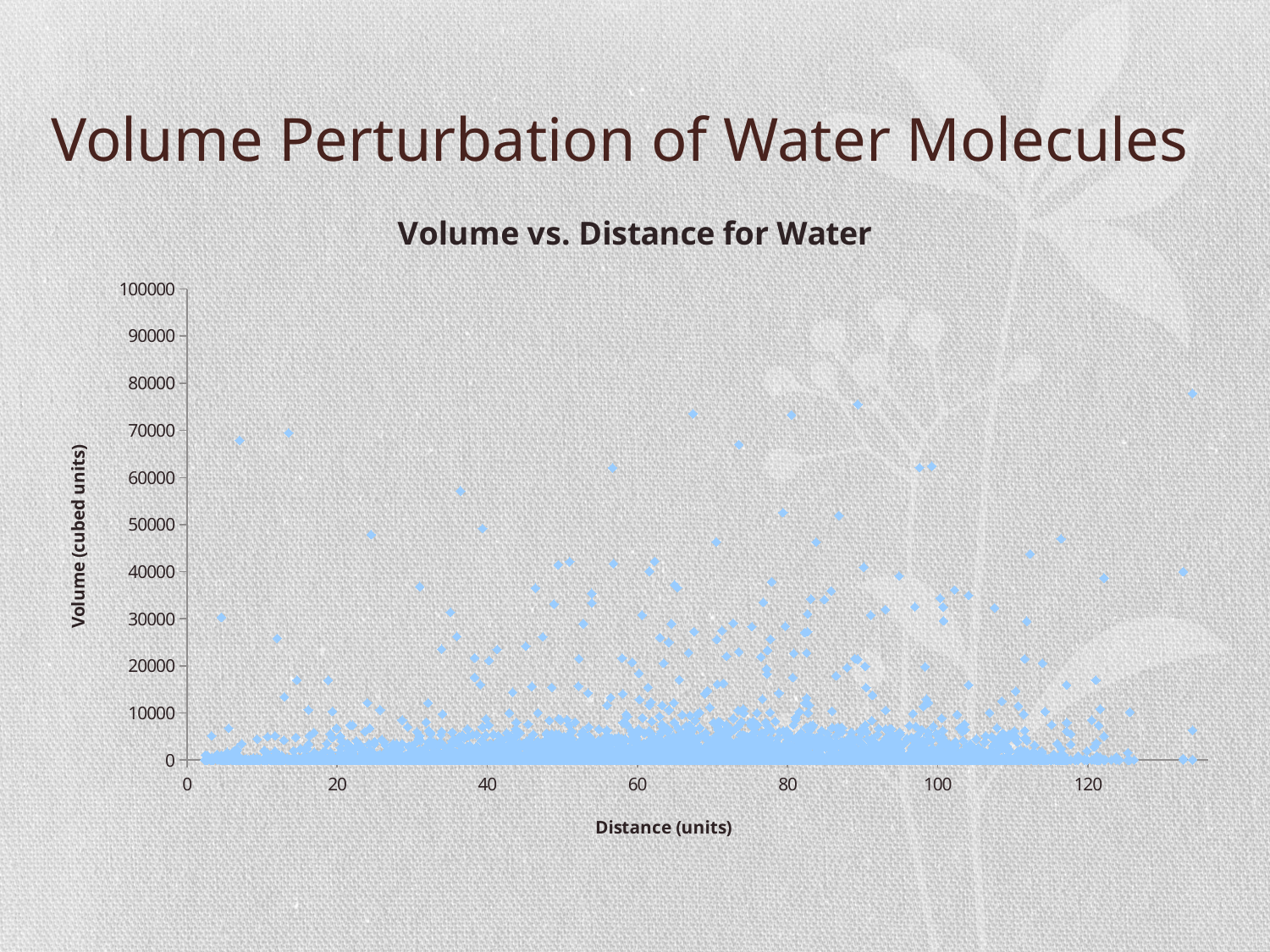
Is the highest plotted point on the chart greater or less than 70000? greater What is the title of the chart? Volume vs. Distance for Water Is the highest plotted point located at a distance greater or less than 120? greater Is the point plotted near a distance of 7 with the highest volume greater or less than 60000? greater What is the label on the vertical axis of the chart? Volume (cubed units) What kind of chart is shown on the slide? Scatter chart